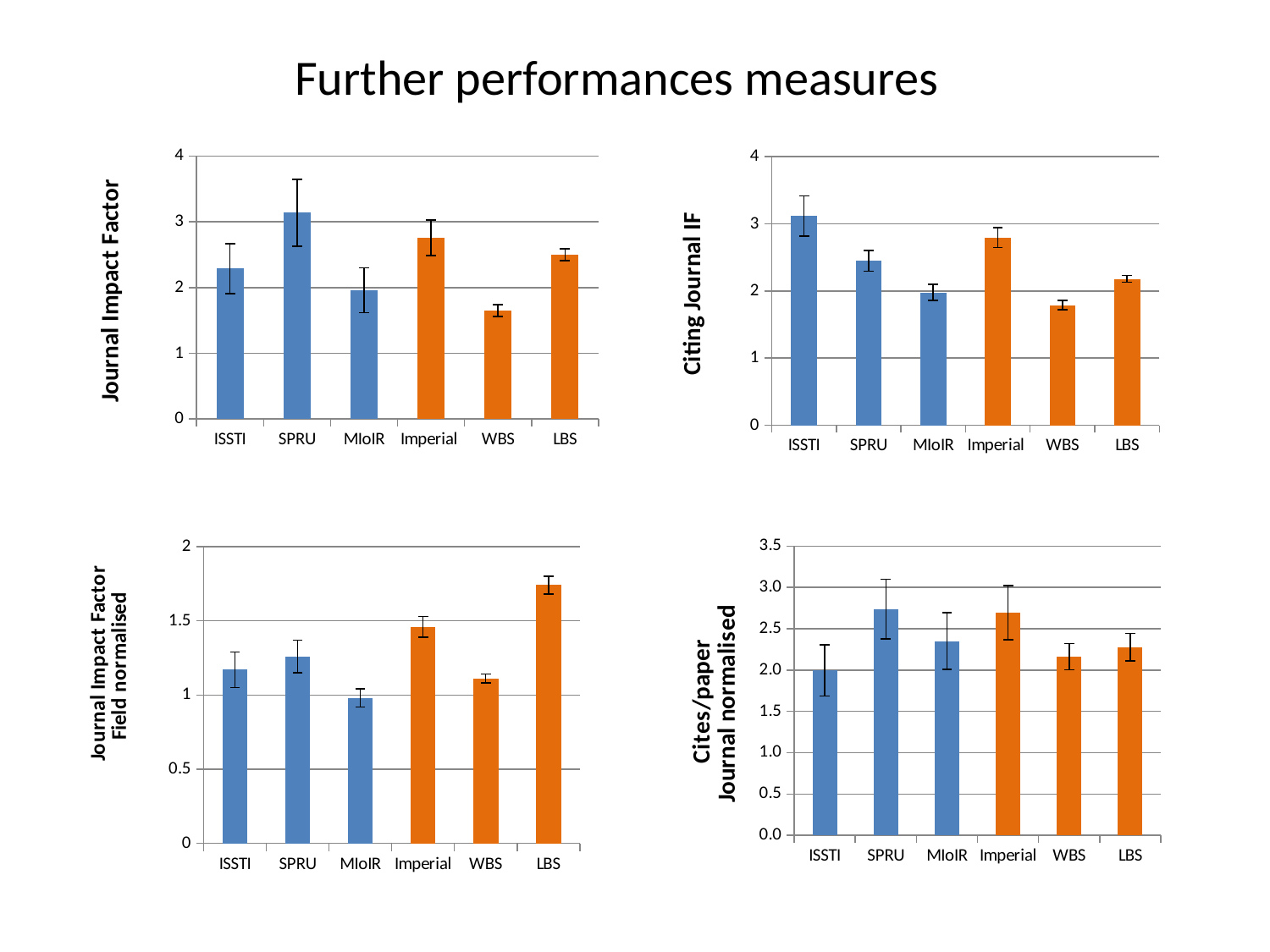
In the Journal Impact Factor chart (top left), which institution has the lowest value? WBS In the Journal Impact Factor Field normalised chart (bottom left), which institution has the lowest value? MIoIR In the Journal Impact Factor Field normalised chart (bottom left), which institution has the highest value? LBS In the Citing Journal IF chart (top right), which institution has the highest value? ISSTI In the Journal Impact Factor chart (top left), is the value for SPRU greater or less than 3? greater In the Citing Journal IF chart (top right), which institution has the lowest value? WBS In the Journal Impact Factor chart (top left), which institution has the highest value? SPRU In the Cites/paper Journal normalised chart (bottom right), is the value for SPRU greater or less than 2.5? greater How many institutions are shown on the x axis of the Citing Journal IF chart (top right)? 6 In the Cites/paper Journal normalised chart (bottom right), which is larger, the value for SPRU or the value for ISSTI? SPRU In the Citing Journal IF chart (top right), is the value for ISSTI greater or less than 3? greater